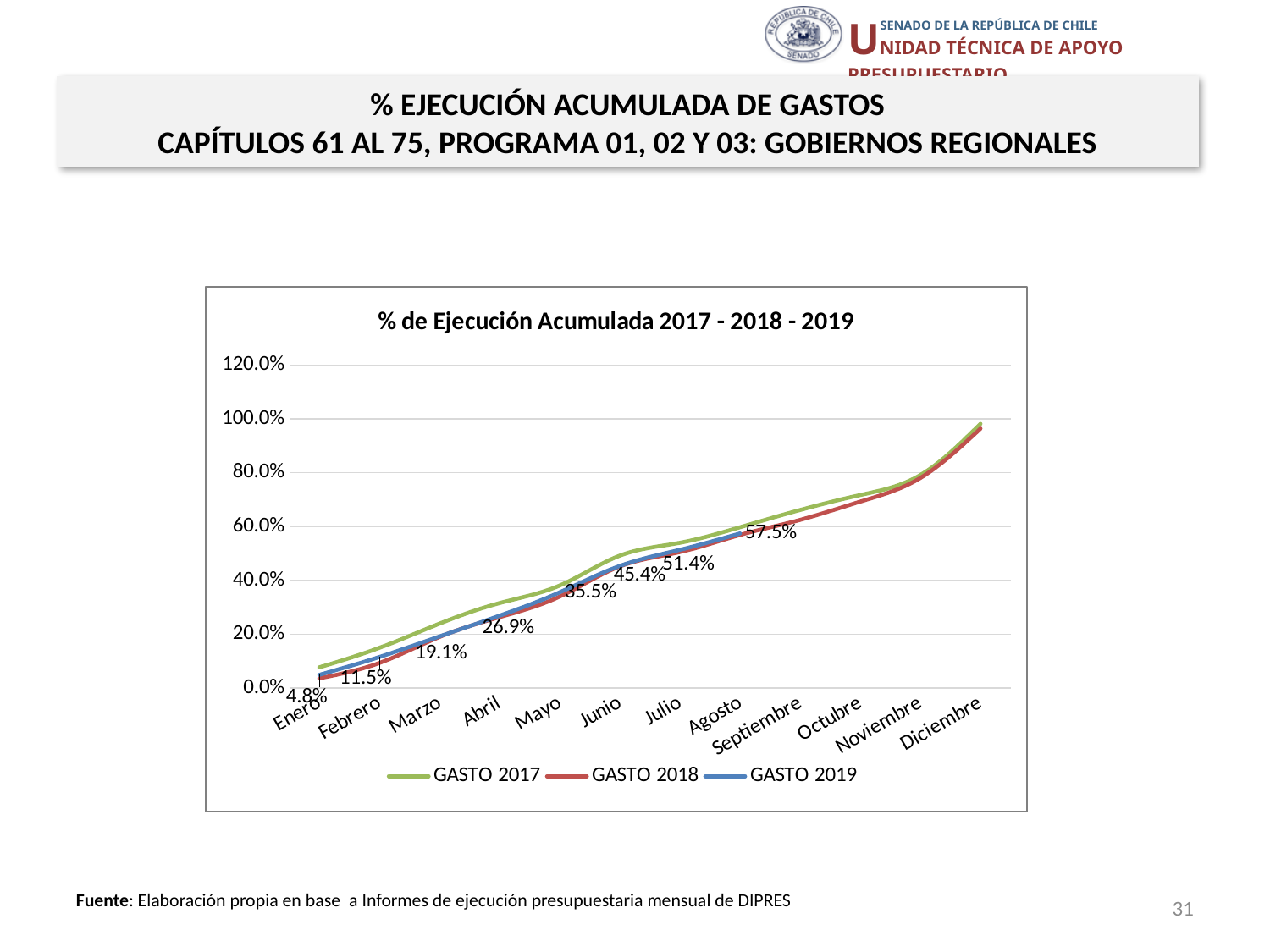
What is the difference between the GASTO 2019 values for Marzo and Febrero? 7.6% What is the value for GASTO 2019 in Abril? 26.9% How many series does the legend list? 3 How many months are shown on the x axis? 12 What is the value for GASTO 2019 in Enero? 4.8% Do the GASTO 2017 values rise or fall from Enero to Diciembre? rise What is the title of the chart? % de Ejecución Acumulada 2017 - 2018 - 2019 What is the value for GASTO 2019 in Junio? 45.4% What kind of chart is shown on the slide? line chart What is the value for GASTO 2019 in Agosto? 57.5% Is the value for GASTO 2017 in Diciembre greater or less than 80.0%? greater What is the difference between the GASTO 2019 values for Julio and Junio? 6.0%